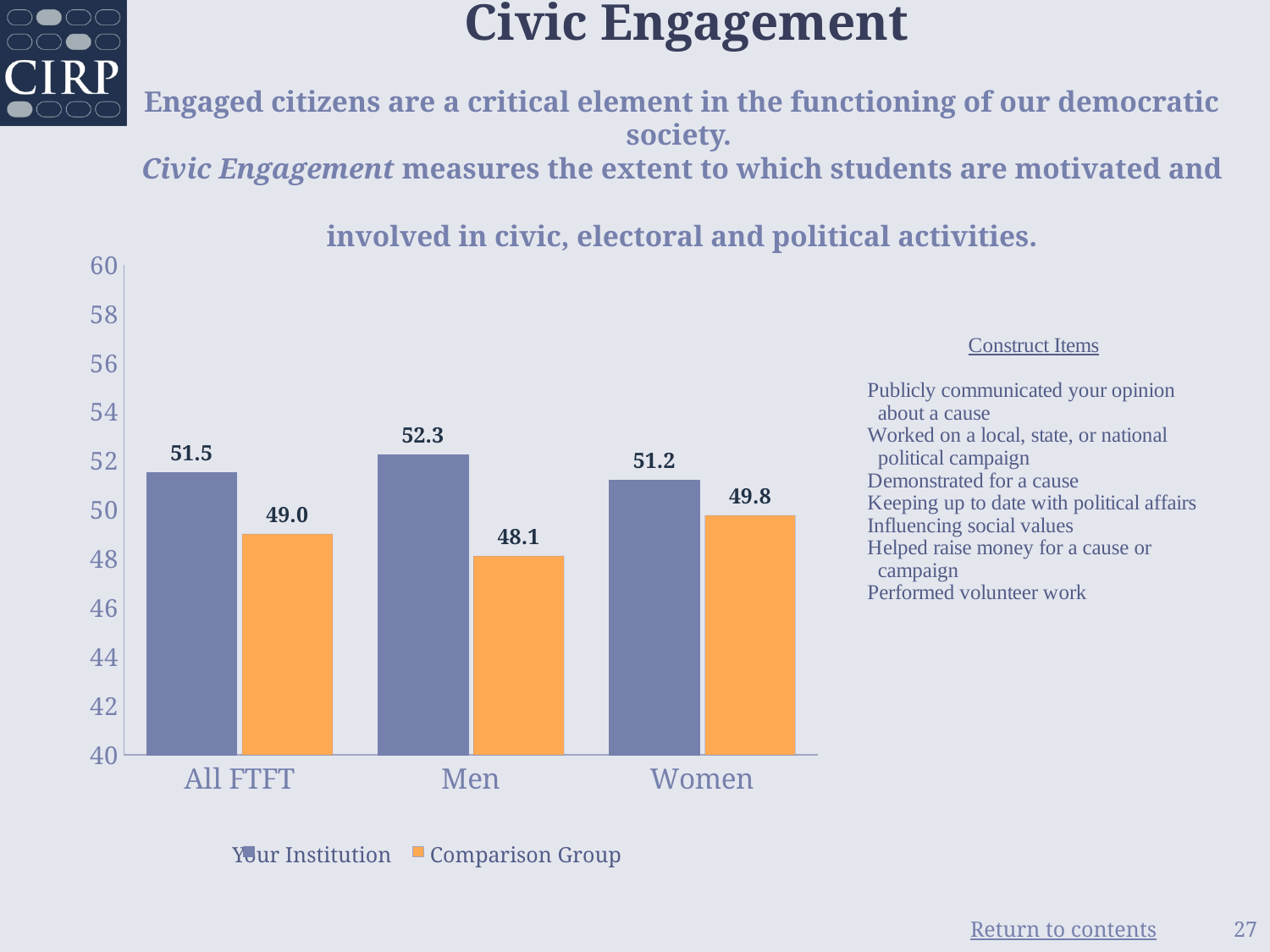
What is the difference between the Your Institution and Comparison Group values for All FTFT? 2.5 Is the Comparison Group value for Men greater or less than 50? less What kind of chart is shown on the slide? bar chart Which category has the highest Your Institution value? Men Which category has the lowest Comparison Group value? Men What is the Comparison Group value for Women? 49.8 How many categories are shown on the x axis? 3 How many series does the legend list? 2 What is the difference between the Your Institution and Comparison Group values for Men? 4.2 What is the Your Institution value for Men? 52.3 What is the Comparison Group value for All FTFT? 49.0 Which is larger for Women: Your Institution or Comparison Group? Your Institution